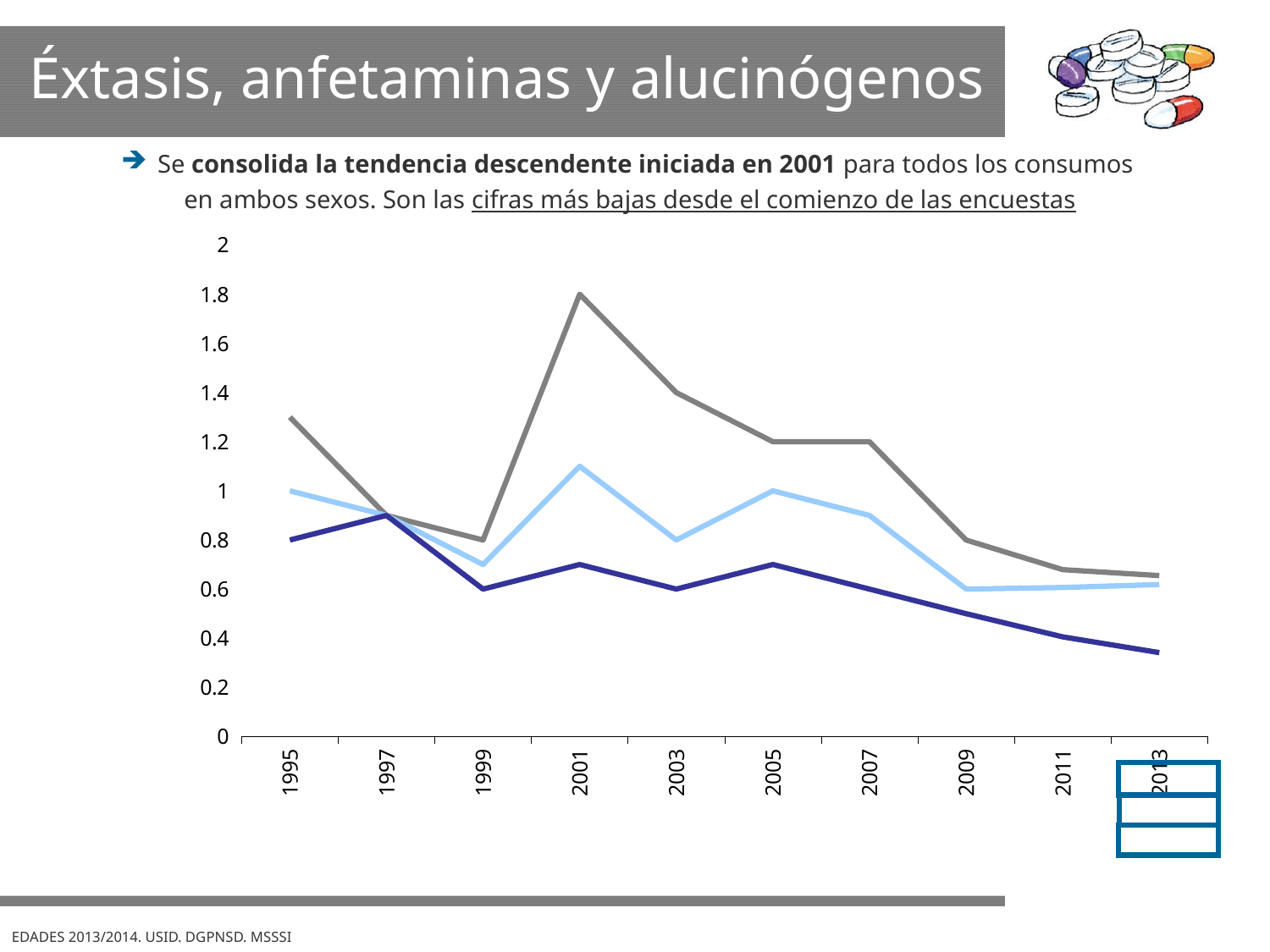
Is the value of the light blue line in 2001 greater or less than 1.2? less Is the value of the gray line in 1995 greater or less than 1.2? greater In which year does the dark blue line reach its lowest value? 2013 In 2001, which line has the higher value, the gray line or the light blue line? gray line Is the value of the gray line in 2013 greater or less than 0.8? less Does the gray line rise or fall between 2007 and 2013? fall What kind of chart is shown on the slide? line chart In which year does the gray line reach its highest value? 2001 How many years are shown on the x axis of the chart? 10 How many lines are plotted on the chart? 3